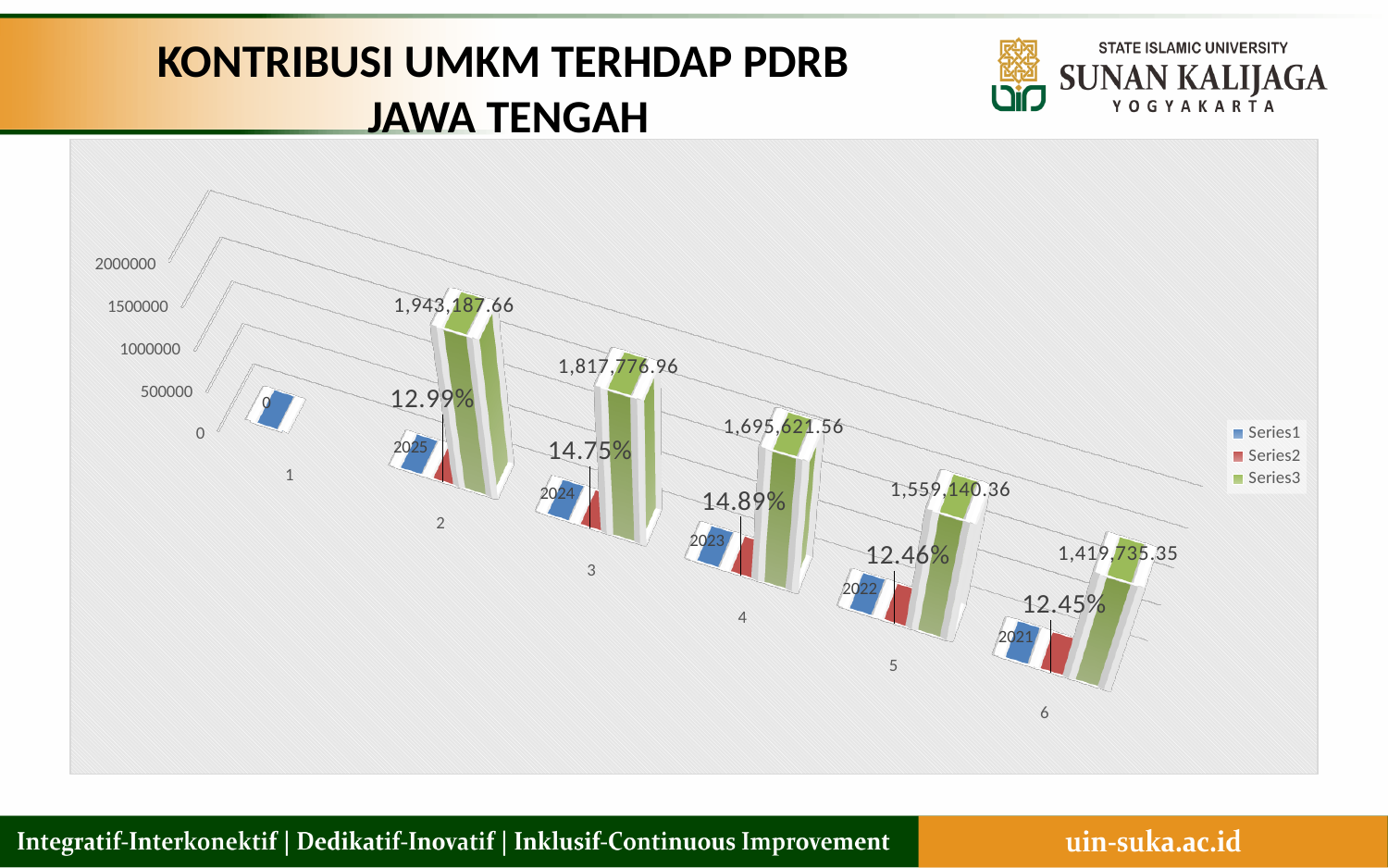
What is the Series2 value for category 4? 14.89% What is the difference between the Series3 values for category 2 and category 3? 125,410.70 What kind of chart is shown on the slide? bar chart How many series does the legend list? 3 Which category has the highest Series3 value? 2 Do the Series3 values rise or fall from category 2 to category 6? fall What is the title of the chart slide? KONTRIBUSI UMKM TERHDAP PDRB JAWA TENGAH What is the Series3 value for category 2? 1,943,187.66 Which category has the highest Series2 value? 4 What is the Series1 label value for category 3? 2024 How many categories are shown on the x axis? 6 What is the Series3 value for category 6? 1,419,735.35